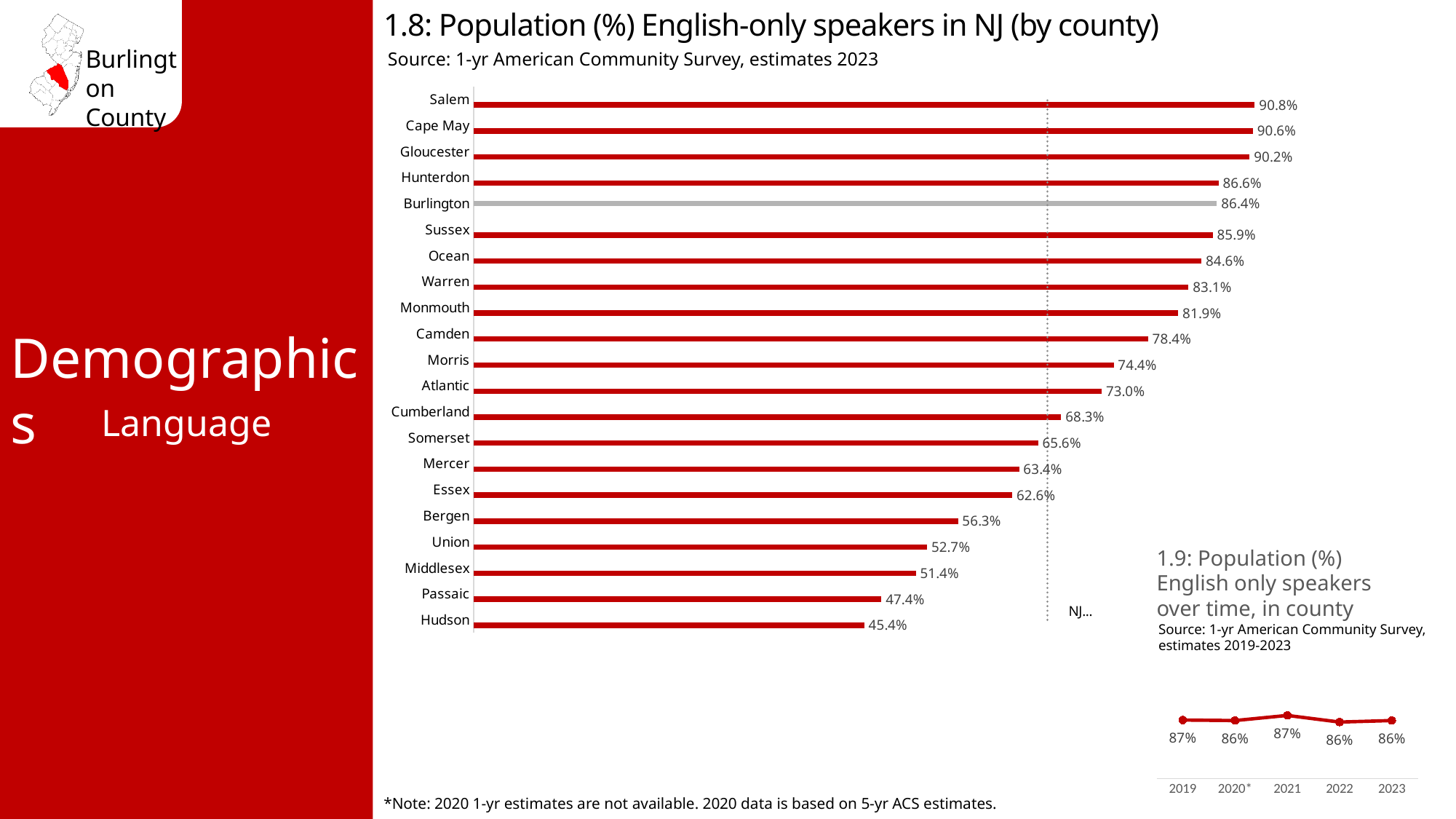
In chart 1.8 (English-only speakers by county), what is the value for Hudson? 45.4% In chart 1.8 (English-only speakers by county), what is the difference between Hunterdon and Burlington? 0.2% In chart 1.8 (English-only speakers by county), what is the value for Burlington? 86.4% In chart 1.8 (English-only speakers by county), which county has the lowest value? Hudson In chart 1.8 (English-only speakers by county), which county has the highest value? Salem In chart 1.8 (English-only speakers by county), what is the difference between Salem and Hudson? 45.4% In chart 1.8 (English-only speakers by county), which is larger, the value for Camden or the value for Morris? Camden In chart 1.8 (English-only speakers by county), how many counties are shown? 21 In chart 1.8 (English-only speakers by county), which county's bar is shown in grey instead of red? Burlington In chart 1.9 (English only speakers over time), what is the value for 2021? 87% In chart 1.9 (English only speakers over time), how many years are plotted? 5 What kind of chart is chart 1.8 (English-only speakers by county)? Bar chart